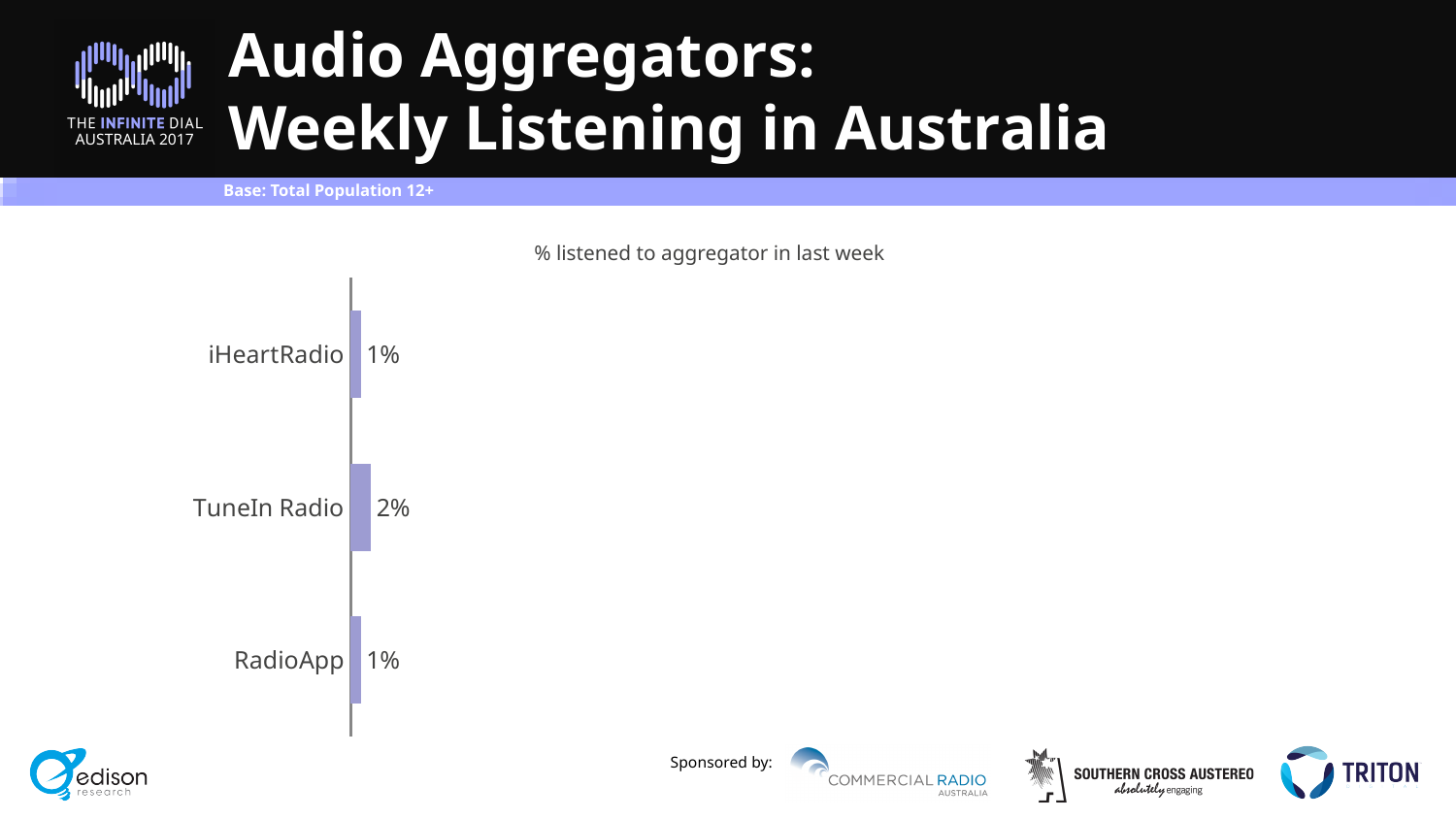
What is the title of the chart? % listened to aggregator in last week What kind of chart is shown on the slide? Bar chart What is the difference between the TuneIn Radio and iHeartRadio values? 1% What percentage listened to iHeartRadio in the last week? 1% How many aggregators are shown in the chart? 3 What base population is the chart based on? Total Population 12+ Which is larger, the value for TuneIn Radio or the value for RadioApp? TuneIn Radio What percentage listened to TuneIn Radio in the last week? 2% What percentage listened to RadioApp in the last week? 1% Which aggregator has the highest weekly listening percentage? TuneIn Radio